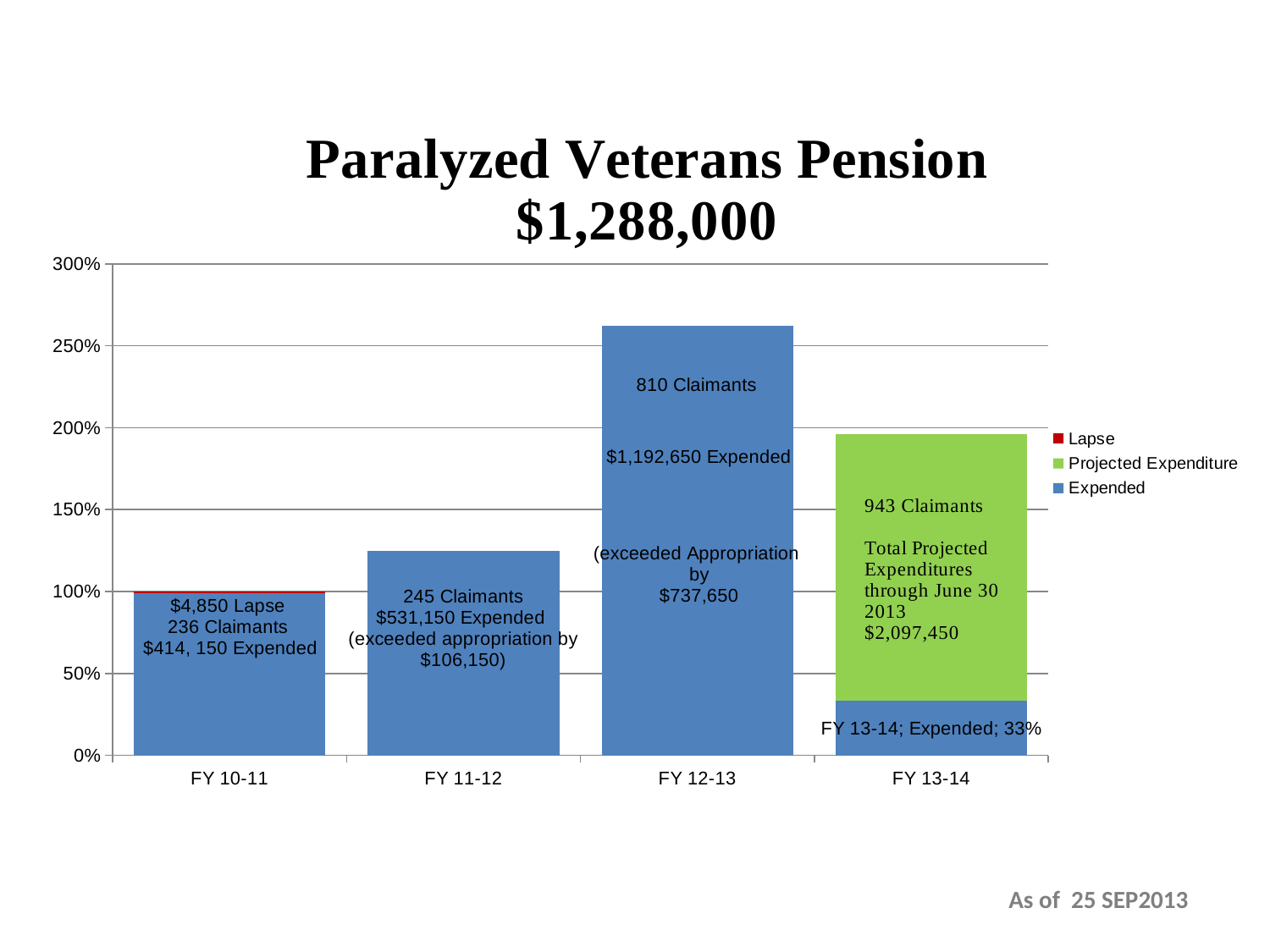
What percentage is labelled for Expended in FY 13-14? 33% Which fiscal year has the tallest bar? FY 12-13 What amount is labelled as Expended for FY 11-12? $531,150 What is the Lapse amount labelled for FY 10-11? $4,850 Is the bar for FY 11-12 greater or less than 150%? less Is the bar for FY 12-13 greater or less than 250%? greater What kind of chart is shown on the slide? Stacked bar chart How many fiscal year categories are shown on the x axis? 4 What are the Total Projected Expenditures through June 30 2013 labelled for FY 13-14? $2,097,450 How many series does the legend list? 3 Which fiscal year has the shortest bar? FY 10-11 How many claimants are labelled for FY 12-13? 810 Claimants